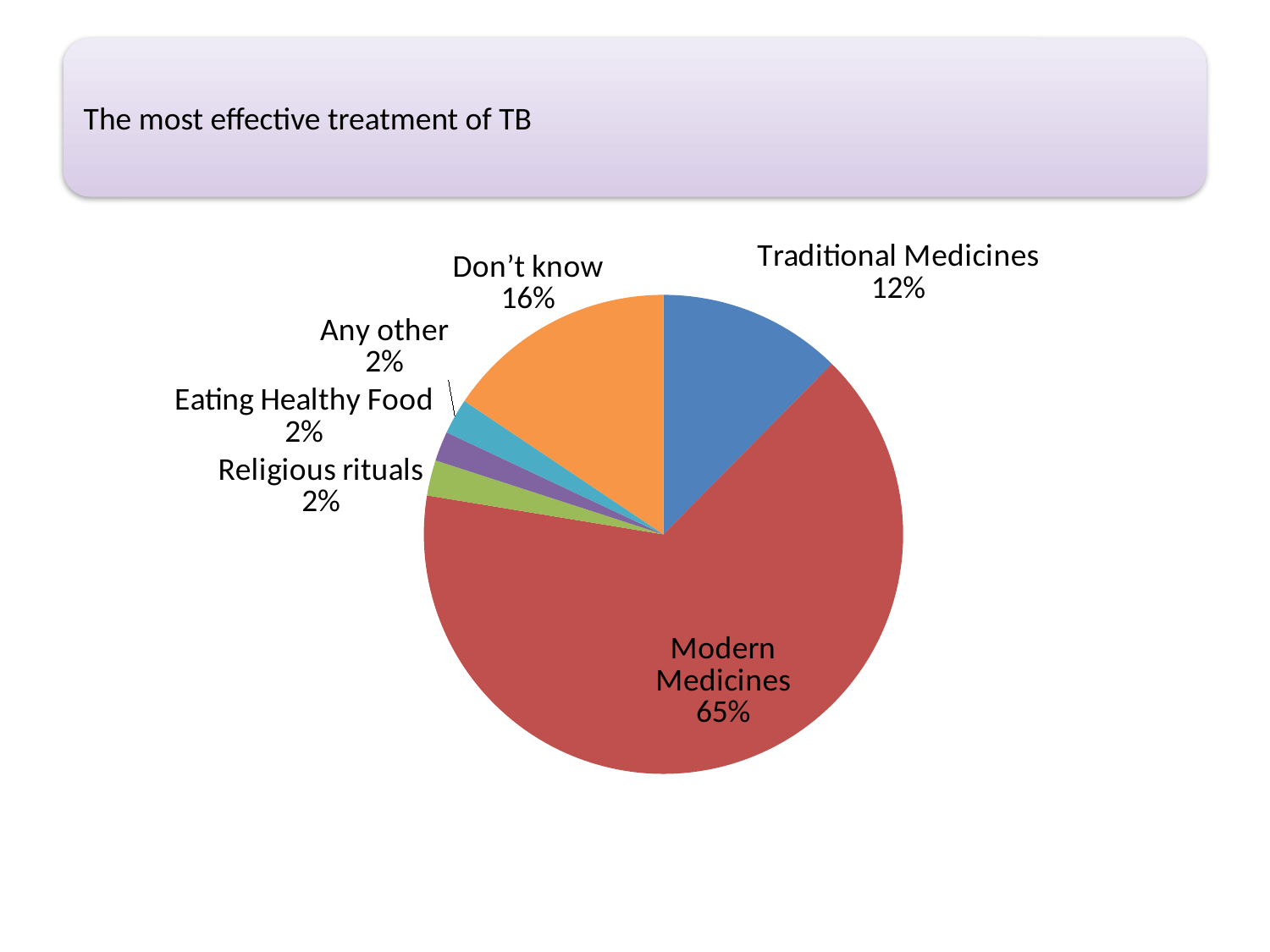
Which category has the largest slice of the pie? Modern Medicines Which is larger, the Traditional Medicines slice or the Don't know slice? Don't know What share of the pie is Traditional Medicines? 12% What is the title of the chart on the slide? The most effective treatment of TB What is the difference in percentage points between Don't know and Traditional Medicines? 4 What share of the pie is Don't know? 16% What share of the pie is Modern Medicines? 65% What is the difference in percentage points between Modern Medicines and Don't know? 49 How many slices does the pie chart have? 6 Which is larger, the Modern Medicines slice or the Traditional Medicines slice? Modern Medicines What kind of chart is shown on the slide? pie chart